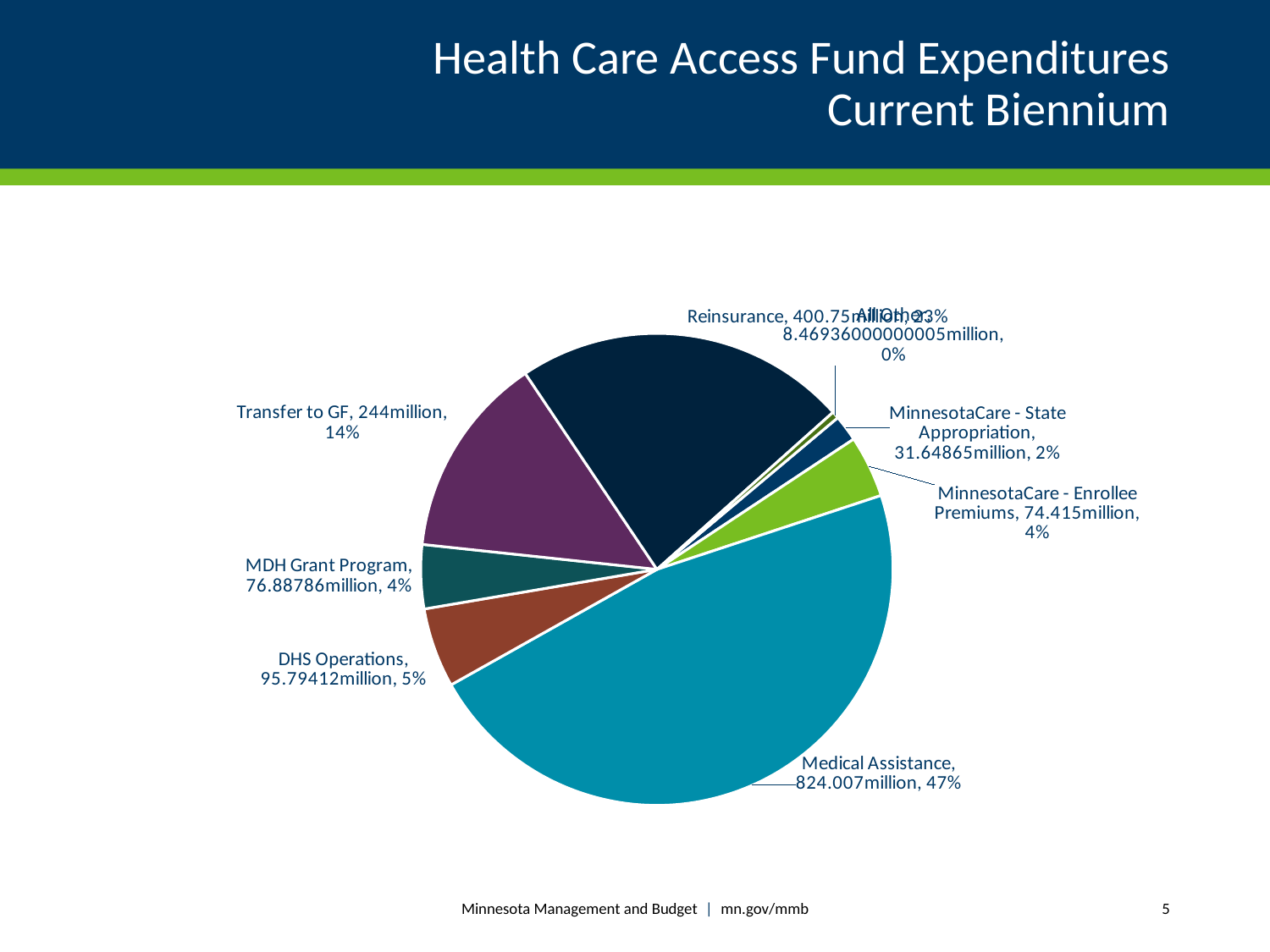
Which category has the largest share of the pie? Medical Assistance What share of the pie does Medical Assistance represent? 47% What is the title of the chart on the slide? Health Care Access Fund Expenditures Current Biennium What share of the pie does MinnesotaCare - State Appropriation represent? 2% Which category has the smallest share of the pie? All Other How many slices does the pie chart have? 8 What is the difference between the values for Medical Assistance and Transfer to GF? 580.007million What is the value for Medical Assistance? 824.007million What is the value for Transfer to GF? 244million Which is larger, the value for DHS Operations or the value for MDH Grant Program? DHS Operations What is the value for DHS Operations? 95.79412million What kind of chart is shown on the slide? Pie chart